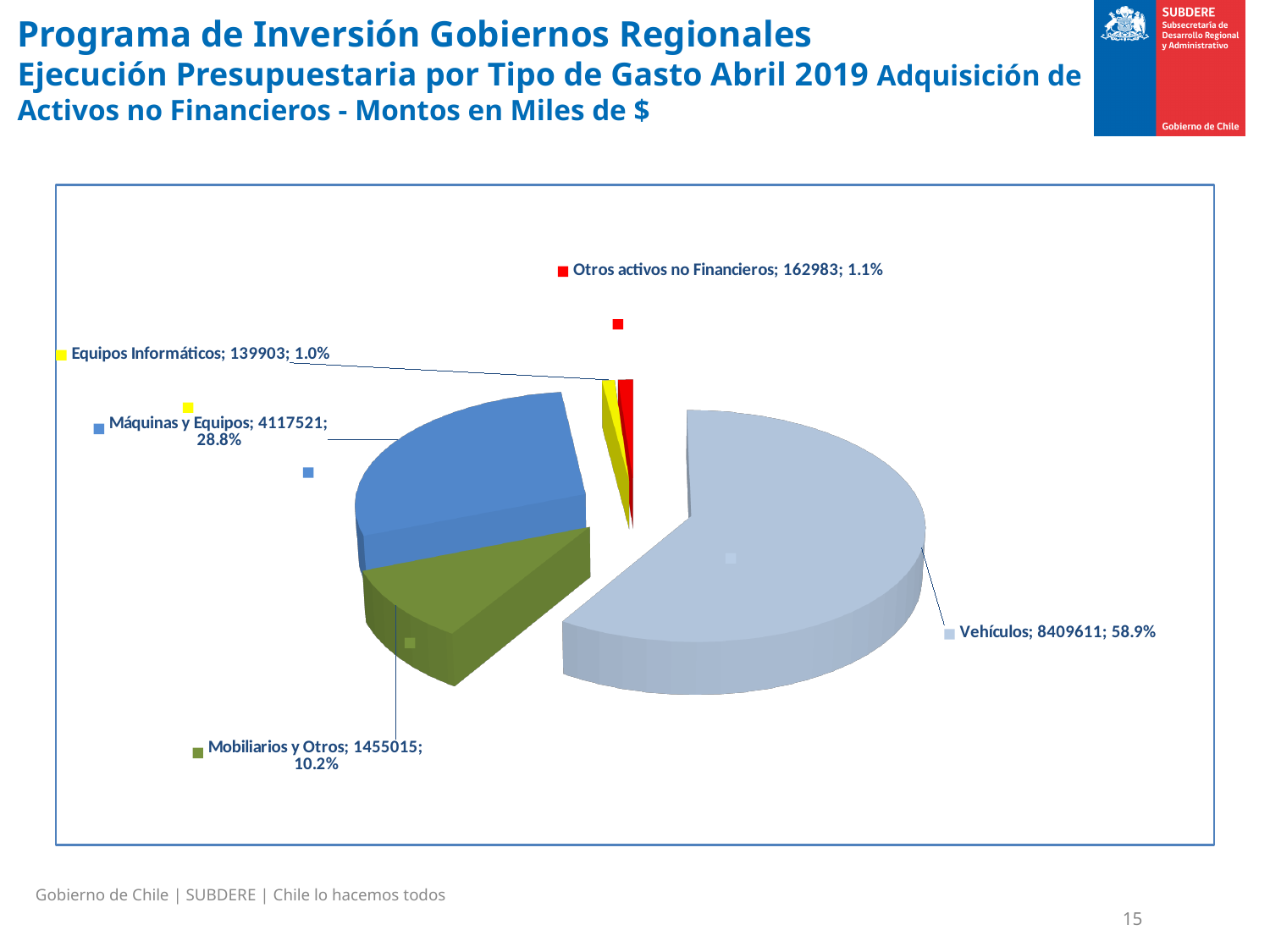
Which is larger, the value for Máquinas y Equipos or the value for Mobiliarios y Otros? Máquinas y Equipos What share of the pie does Máquinas y Equipos represent? 28.8% Which category has the largest slice? Vehículos Which category has the smallest slice? Equipos Informáticos What is the difference between the values for Vehículos and Máquinas y Equipos? 4292090 What is the value for Vehículos? 8409611 What colour is the Vehículos slice? Light blue What kind of chart is shown on the slide? Pie chart What is the difference between the values for Otros activos no Financieros and Equipos Informáticos? 23080 How many slices does the pie chart have? 5 What is the value for Mobiliarios y Otros? 1455015 What share of the pie does Otros activos no Financieros represent? 1.1%